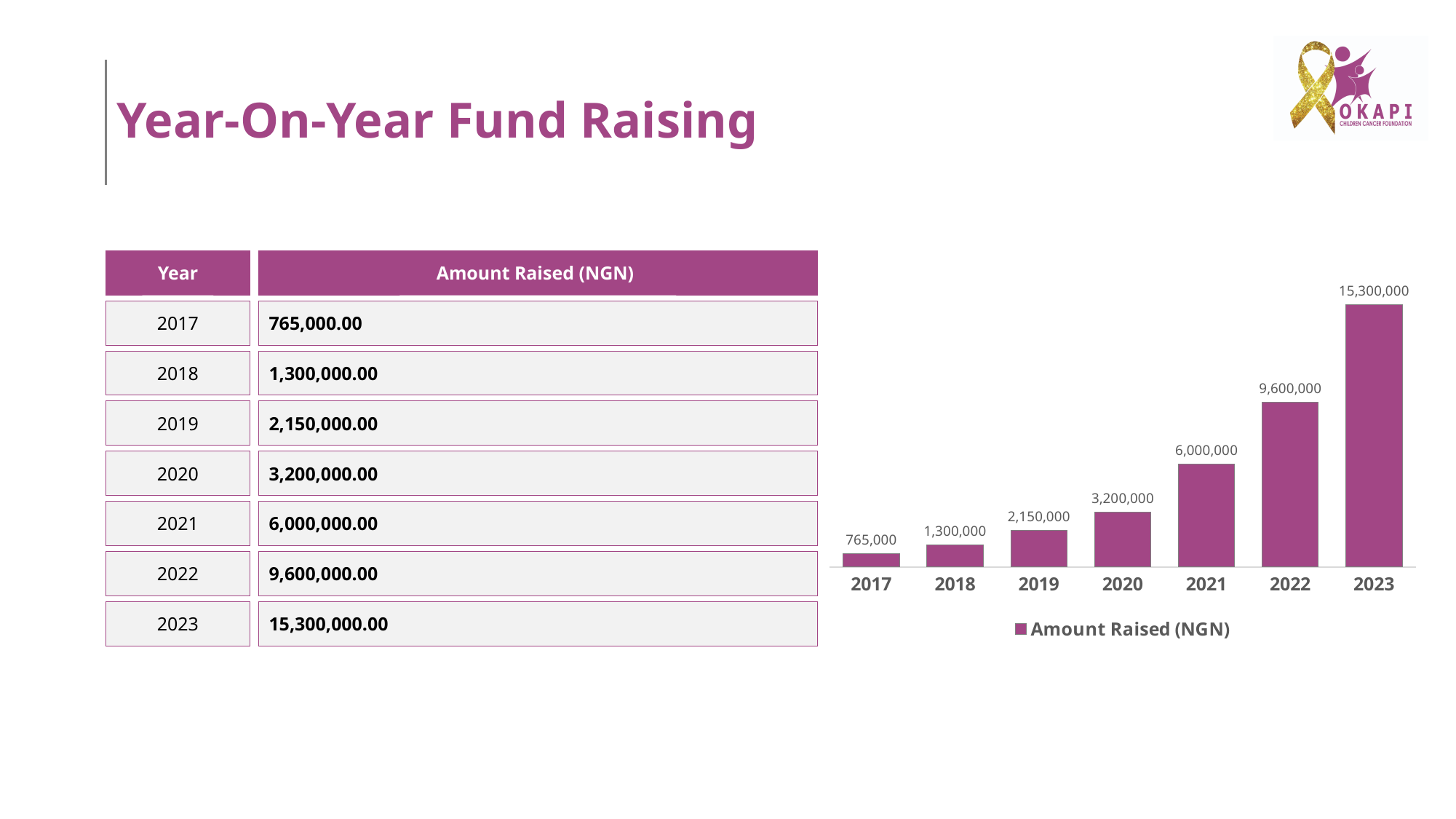
Which year has the lowest amount raised? 2017 What is the difference between the amount raised in 2023 and in 2022? 5,700,000 What is the difference between the amount raised in 2021 and in 2020? 2,800,000 What kind of chart is shown on the slide? Bar chart What amount was raised in 2019 according to the chart? 2,150,000 What amount was raised in 2017 according to the chart? 765,000 How many years are shown in the chart? 7 Which year has the highest amount raised? 2023 Does the amount raised rise or fall from 2017 to 2023? Rise Which year had a larger amount raised, 2018 or 2020? 2020 What amount was raised in 2022 according to the chart? 9,600,000 How many series does the chart legend list? 1